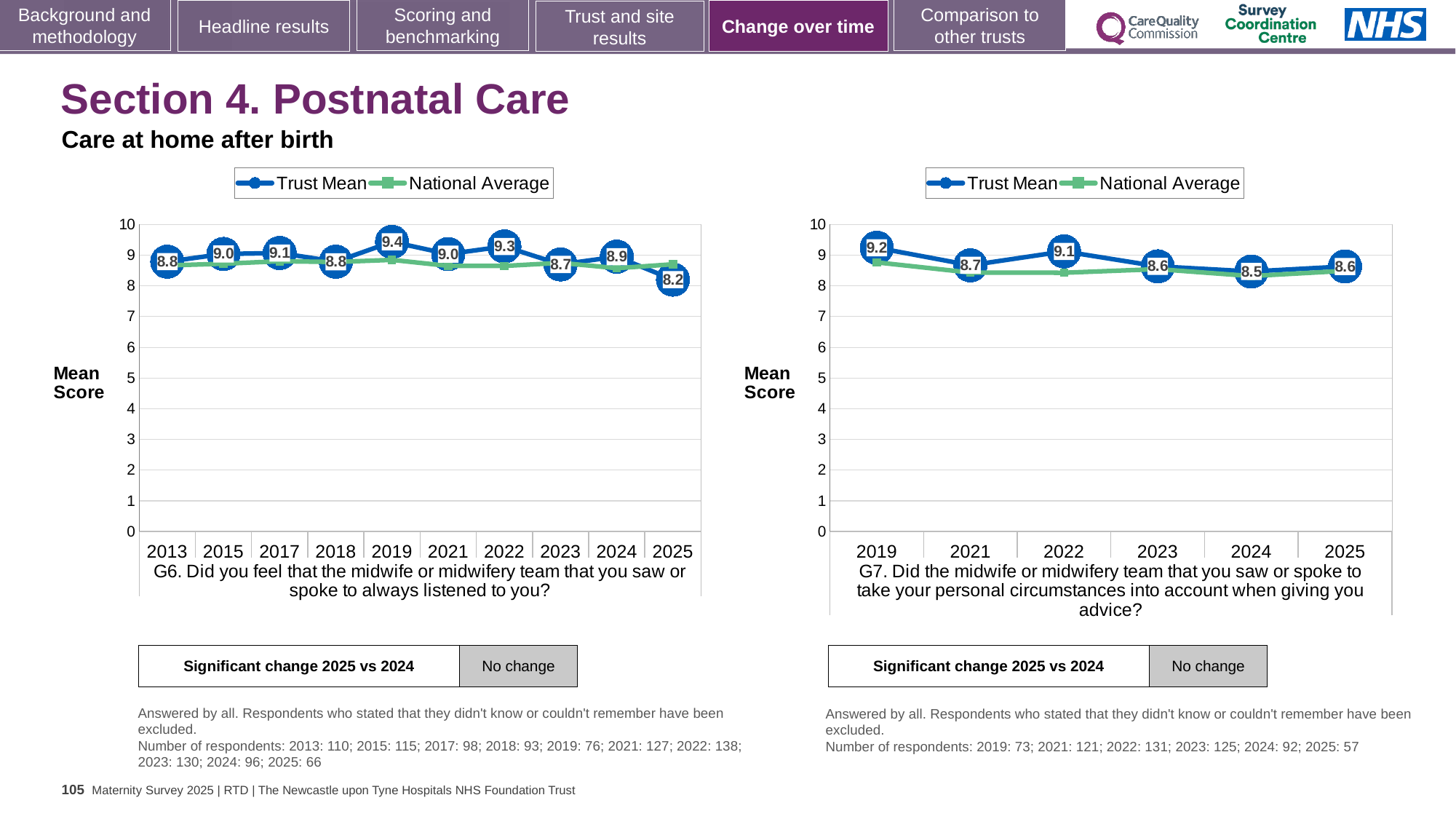
In the G7 chart on the right, which year has the lowest Trust Mean? 2024 In the G7 chart on the right, is the Trust Mean for 2022 larger than for 2021? Yes In the G6 chart on the left, how many years are plotted on the x axis? 10 In the G6 chart on the left, what is the difference between the Trust Mean for 2024 and 2025? 0.7 How many series does the legend of the G7 chart on the right list? 2 In the G6 chart on the left, what is the Trust Mean for 2025? 8.2 In the G6 chart on the left, which year has the highest Trust Mean? 2019 In the G7 chart on the right, is the National Average for 2025 greater or less than 7? greater In the G6 chart on the left, which year has the lowest Trust Mean? 2025 In the G6 chart on the left, what is the Trust Mean for 2019? 9.4 What kind of chart is the G6 chart on the left? Line chart In the G7 chart on the right, what is the Trust Mean for 2019? 9.2